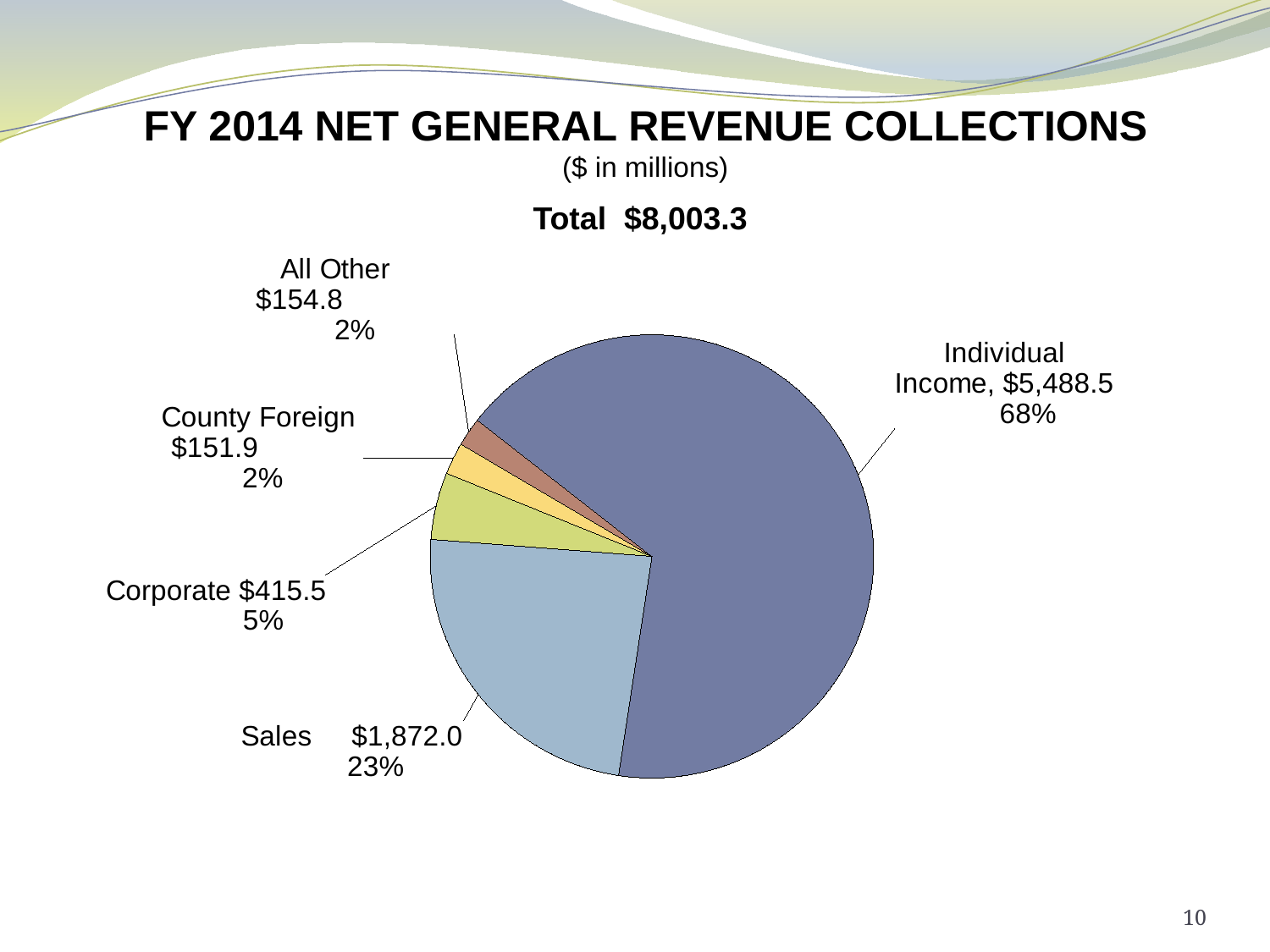
Which category has the largest slice of the pie? Individual Income What is the value for Individual Income? $5,488.5 Which is larger, Sales or Corporate? Sales What is the value for Corporate? $415.5 What type of chart is shown on the slide? Pie chart What share of the pie does Sales represent? 23% What is the difference between Individual Income and Sales? $3,616.5 What is the value for County Foreign? $151.9 How many slices does the pie chart have? 5 What total is shown above the pie chart? $8,003.3 What is the value for Sales? $1,872.0 What share of the pie does Individual Income represent? 68%